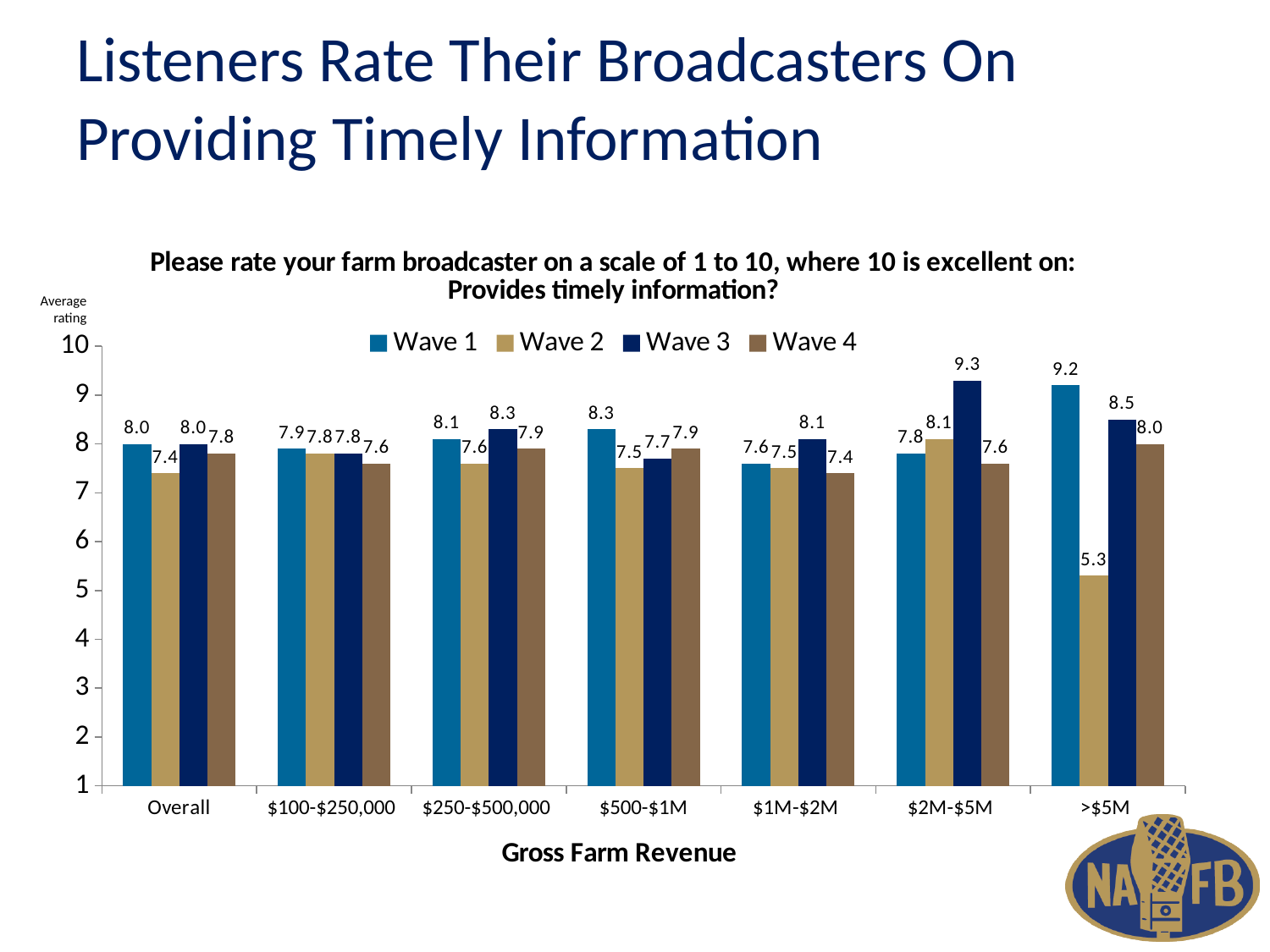
How many gross farm revenue categories are shown on the x axis? 7 How many series does the legend list? 4 What is the Wave 3 rating for the $2M-$5M gross farm revenue group? 9.3 Which gross farm revenue group has the highest Wave 1 rating? >$5M Which is larger for the $1M-$2M group, the Wave 3 rating or the Wave 4 rating? Wave 3 What kind of chart is shown on the slide? Bar chart What is the difference between the Wave 1 and Wave 2 ratings for the >$5M group? 3.9 What is the Wave 1 rating for the Overall category? 8.0 Which gross farm revenue group has the lowest Wave 2 rating? >$5M What is the Wave 2 rating for the >$5M gross farm revenue group? 5.3 What is the label of the x axis? Gross Farm Revenue What is the Wave 4 rating for the $500-$1M group? 7.9